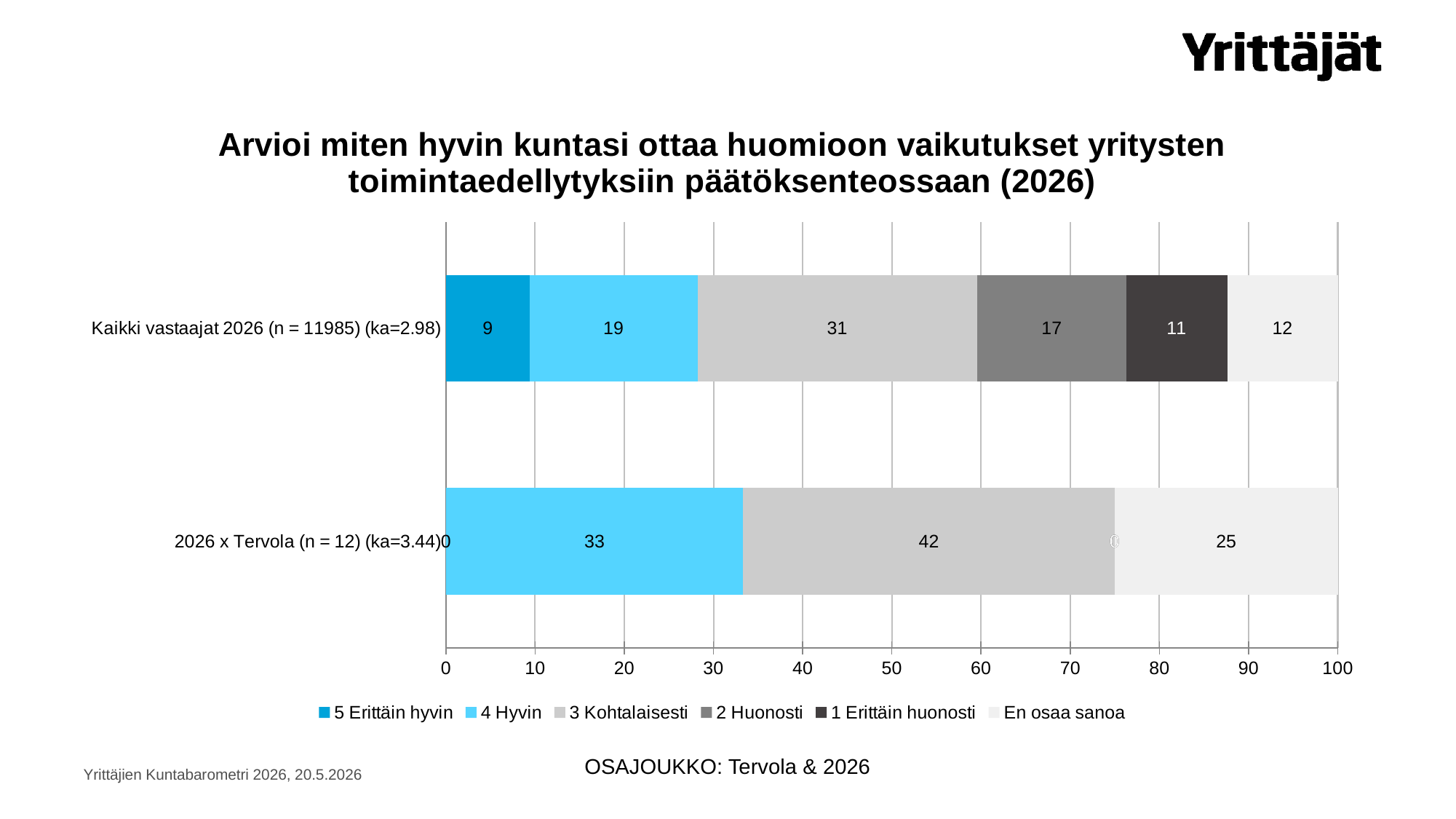
What is the value of 'En osaa sanoa' for '2026 x Tervola (n = 12) (ka=3.44)'? 25 What is the value of '1 Erittäin huonosti' for 'Kaikki vastaajat 2026 (n = 11985) (ka=2.98)'? 11 How many categories (bars) are shown in the chart? 2 What is the total of the stacked bar for 'Kaikki vastaajat 2026 (n = 11985) (ka=2.98)'? 99 What is the value of '3 Kohtalaisesti' for 'Kaikki vastaajat 2026 (n = 11985) (ka=2.98)'? 31 What is the value of '4 Hyvin' for '2026 x Tervola (n = 12) (ka=3.44)'? 33 What is the difference between the '3 Kohtalaisesti' values for '2026 x Tervola (n = 12) (ka=3.44)' and 'Kaikki vastaajat 2026 (n = 11985) (ka=2.98)'? 11 How many series does the legend list? 6 Which category has the larger '4 Hyvin' value, 'Kaikki vastaajat 2026 (n = 11985) (ka=2.98)' or '2026 x Tervola (n = 12) (ka=3.44)'? 2026 x Tervola (n = 12) (ka=3.44) What kind of chart is shown on the slide? stacked bar chart Which series has the smallest value in the 'Kaikki vastaajat 2026 (n = 11985) (ka=2.98)' bar? 5 Erittäin hyvin Which series has the largest value in the 'Kaikki vastaajat 2026 (n = 11985) (ka=2.98)' bar? 3 Kohtalaisesti